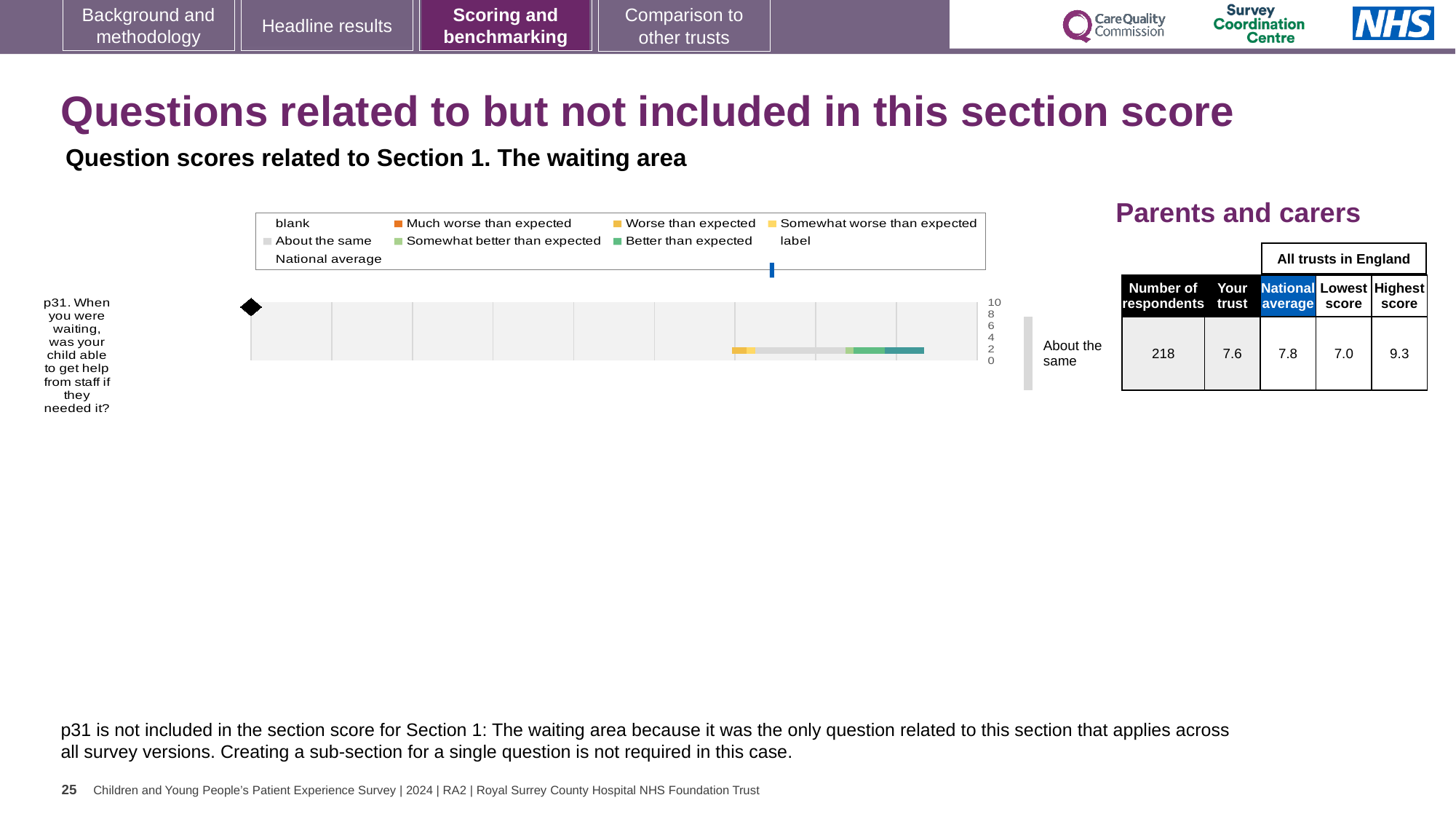
What kind of chart is used to show the p31 question score? bar chart For p31, which is larger: the 'Your trust' score or the national average? National average Which question number is plotted in the chart? p31 In the table next to the chart, what is the national average score for p31? 7.8 In the table next to the chart, how many respondents answered p31? 218 How many questions are plotted in the chart? 1 In the table next to the chart, what is the highest score among all trusts in England for p31? 9.3 What comparison label is shown to the right of the p31 bar? About the same In the table next to the chart, what is the lowest score among all trusts in England for p31? 7.0 In the table next to the chart, what is the 'Your trust' score for p31? 7.6 How many entries does the chart legend list? 9 For p31, what is the difference between the highest score and the lowest score among all trusts in England? 2.3